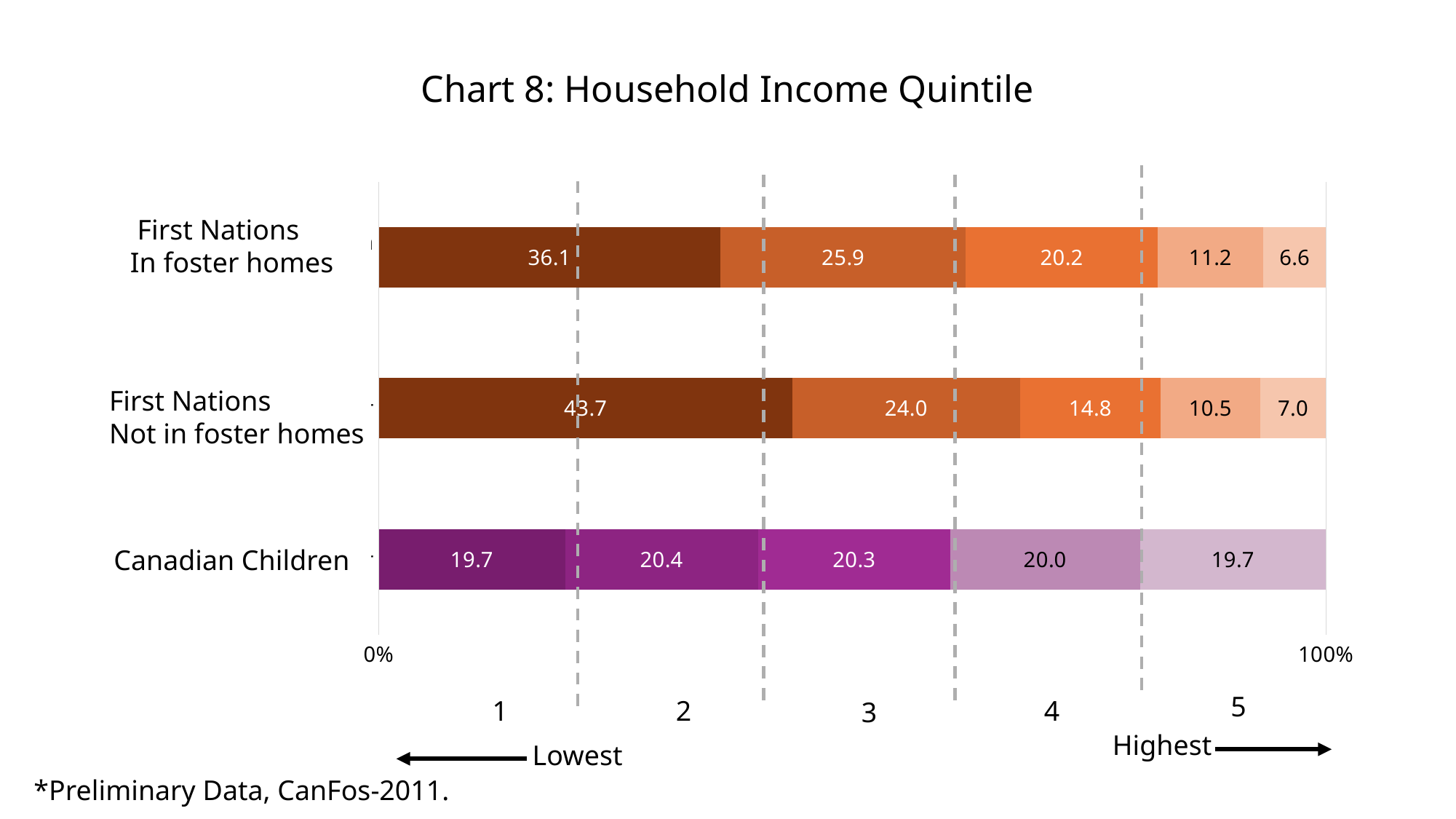
How many quintile segments make up each bar? 5 What kind of chart is this? Stacked bar chart How many groups (bars) are shown in the chart? 3 Which group has the highest value in quintile 1? First Nations Not in foster homes What is the difference between the quintile 4 values for First Nations In foster homes and First Nations Not in foster homes? 0.7 What is the difference between the quintile 1 values for First Nations Not in foster homes and First Nations In foster homes? 7.6 Which quintile has the lowest value for First Nations In foster homes? 5 For First Nations Not in foster homes, do the values rise or fall from quintile 1 to quintile 5? Fall In quintile 3, which is larger: First Nations In foster homes or First Nations Not in foster homes? First Nations In foster homes What is the value for quintile 5 for First Nations Not in foster homes? 7.0 What is the value for quintile 3 for Canadian Children? 20.3 What is the value for quintile 1 for First Nations In foster homes? 36.1